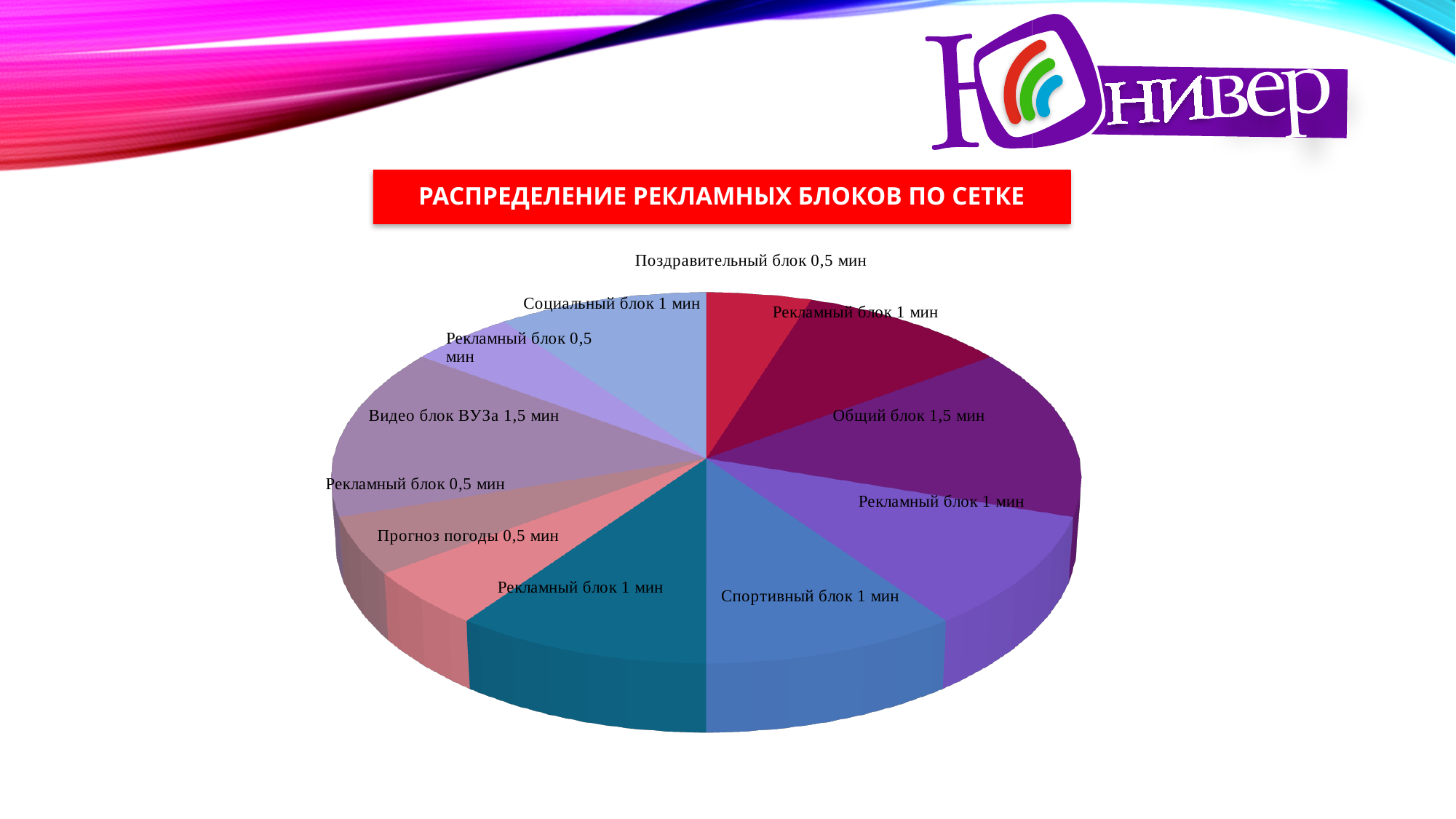
What is the duration of the Поздравительный блок slice? 0,5 мин What is the duration of the Прогноз погоды slice? 0,5 мин What is the difference in duration between the Общий блок slice and the Поздравительный блок slice? 1 мин How many slices does the pie chart have? 11 What is the total duration of all slices in the pie? 10 мин What is the duration of the Видео блок ВУЗа slice? 1,5 мин Which is larger, the Общий блок slice or the Прогноз погоды slice? Общий блок What share of the pie does the Общий блок 1,5 мин slice represent? 15% How many slices in the pie are labelled Рекламный блок? 5 What kind of chart is shown on the slide? pie chart What is the duration of the Спортивный блок slice? 1 мин What is the title shown above the chart? РАСПРЕДЕЛЕНИЕ РЕКЛАМНЫХ БЛОКОВ ПО СЕТКЕ